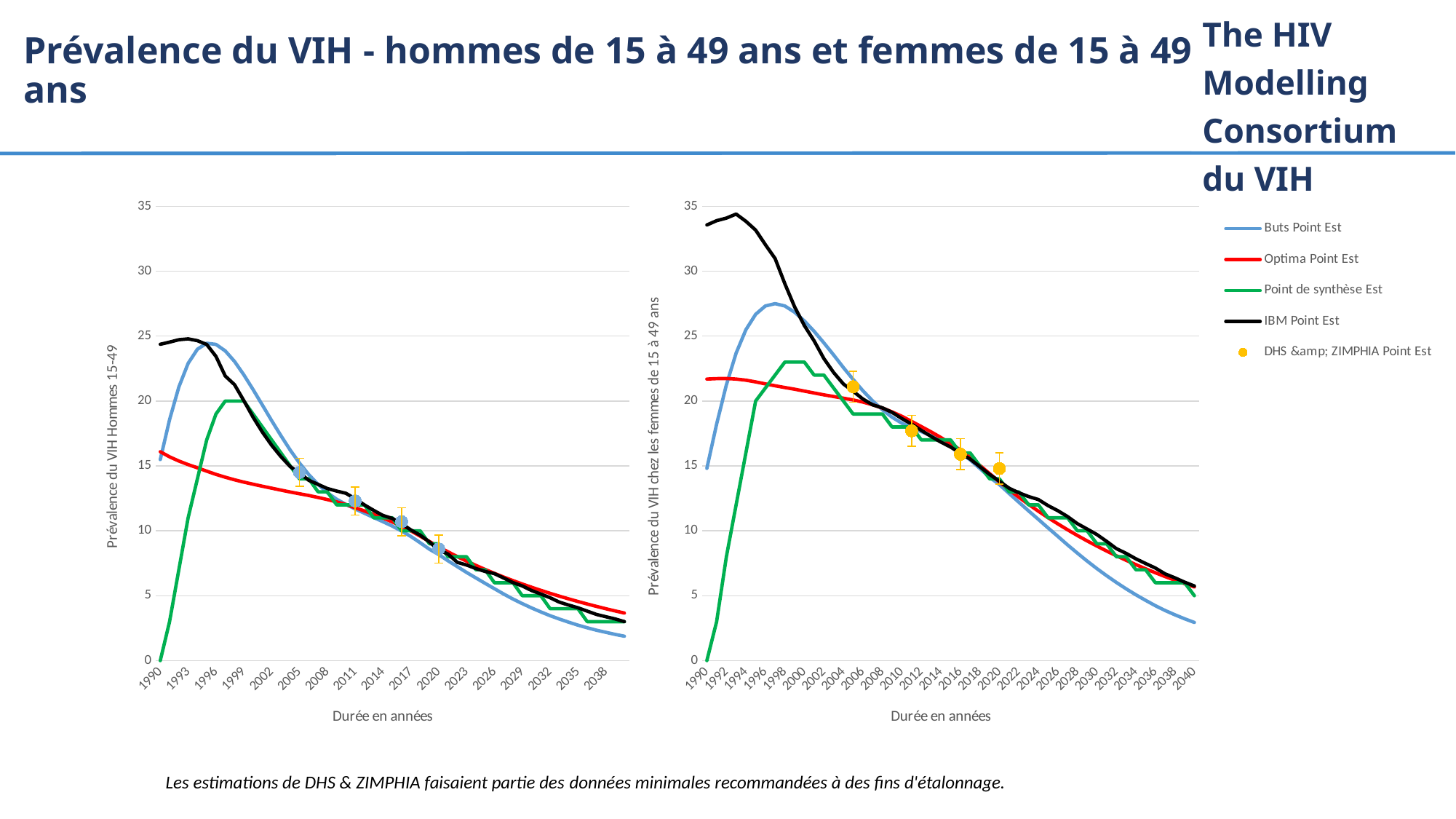
What is the x-axis title of the left chart? Durée en années In the right chart (femmes de 15 à 49 ans), does the Buts Point Est line rise or fall from 2000 to 2040? fall In the left chart (Hommes 15-49), which line is higher in 1996: Buts Point Est or Point de synthèse Est? Buts Point Est In the left chart (Hommes 15-49), is the value of the Buts Point Est line in 2038 greater or less than 5? less In the left chart (Hommes 15-49), does the Optima Point Est line rise or fall from 1990 to 2040? fall In the left chart (Hommes 15-49), is the value of the Optima Point Est line in 1990 greater or less than 20? less In the right chart (femmes de 15 à 49 ans), which line is higher in 1994: IBM Point Est or Buts Point Est? IBM Point Est In the right chart (femmes de 15 à 49 ans), is the peak value of the IBM Point Est line greater or less than 30? greater What kind of chart is the left chart (Prévalence du VIH Hommes 15-49)? line chart How many series does the legend list? 5 How many DHS & ZIMPHIA Point Est points are plotted on the right chart (femmes de 15 à 49 ans)? 4